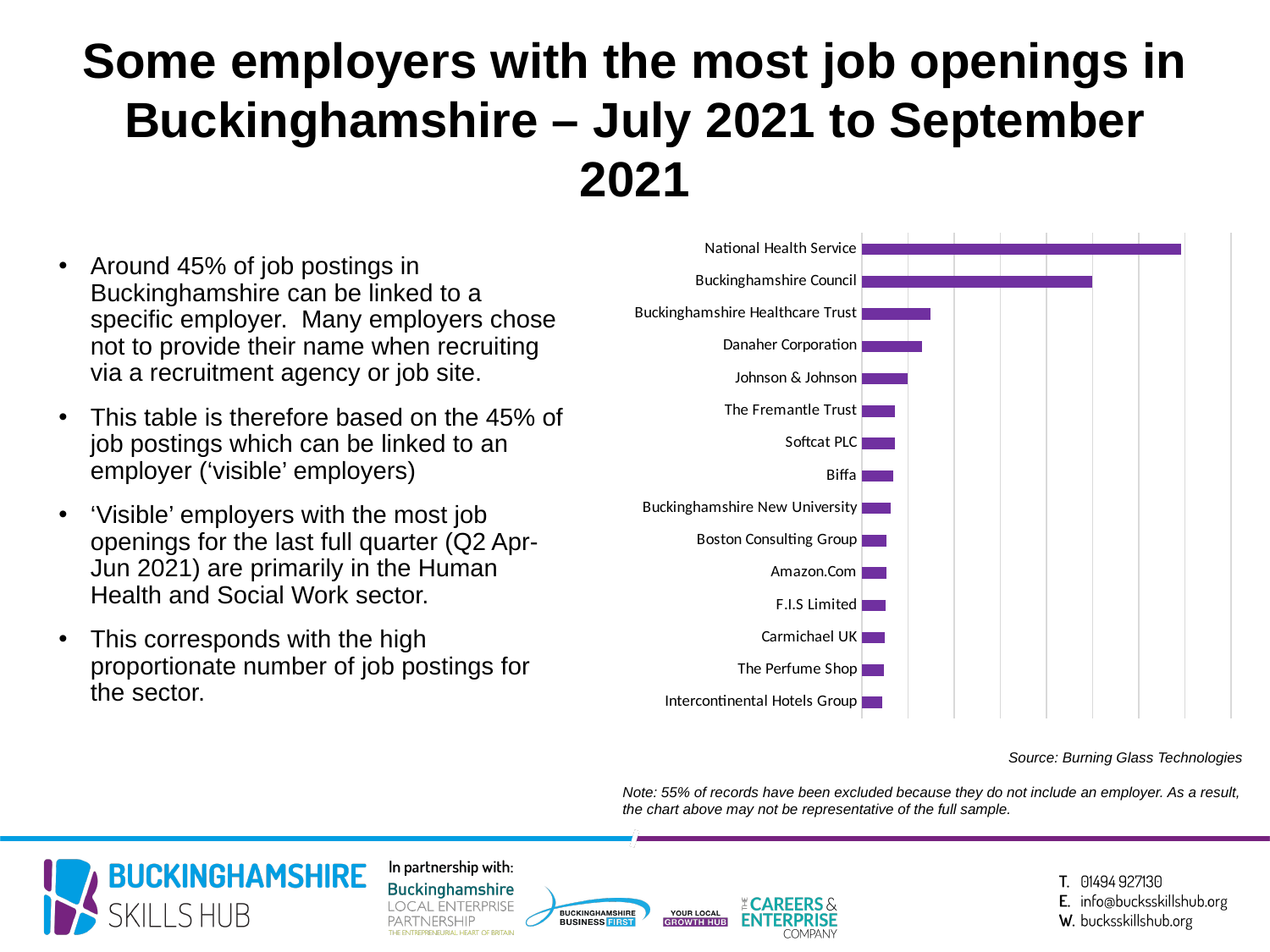
Which has more job openings in the chart, National Health Service or Buckinghamshire Council? National Health Service Which has more job openings in the chart, Buckinghamshire Council or Buckinghamshire Healthcare Trust? Buckinghamshire Council Which has more job openings in the chart, Danaher Corporation or Softcat PLC? Danaher Corporation How many employers are listed in the chart? 15 Do the bar lengths increase or decrease going from the top of the chart to the bottom? decrease Which employer has the longest bar in the chart? National Health Service Which employer is listed second from the top in the chart? Buckinghamshire Council What colour are the bars in the chart? purple What kind of chart is shown on the slide? bar chart